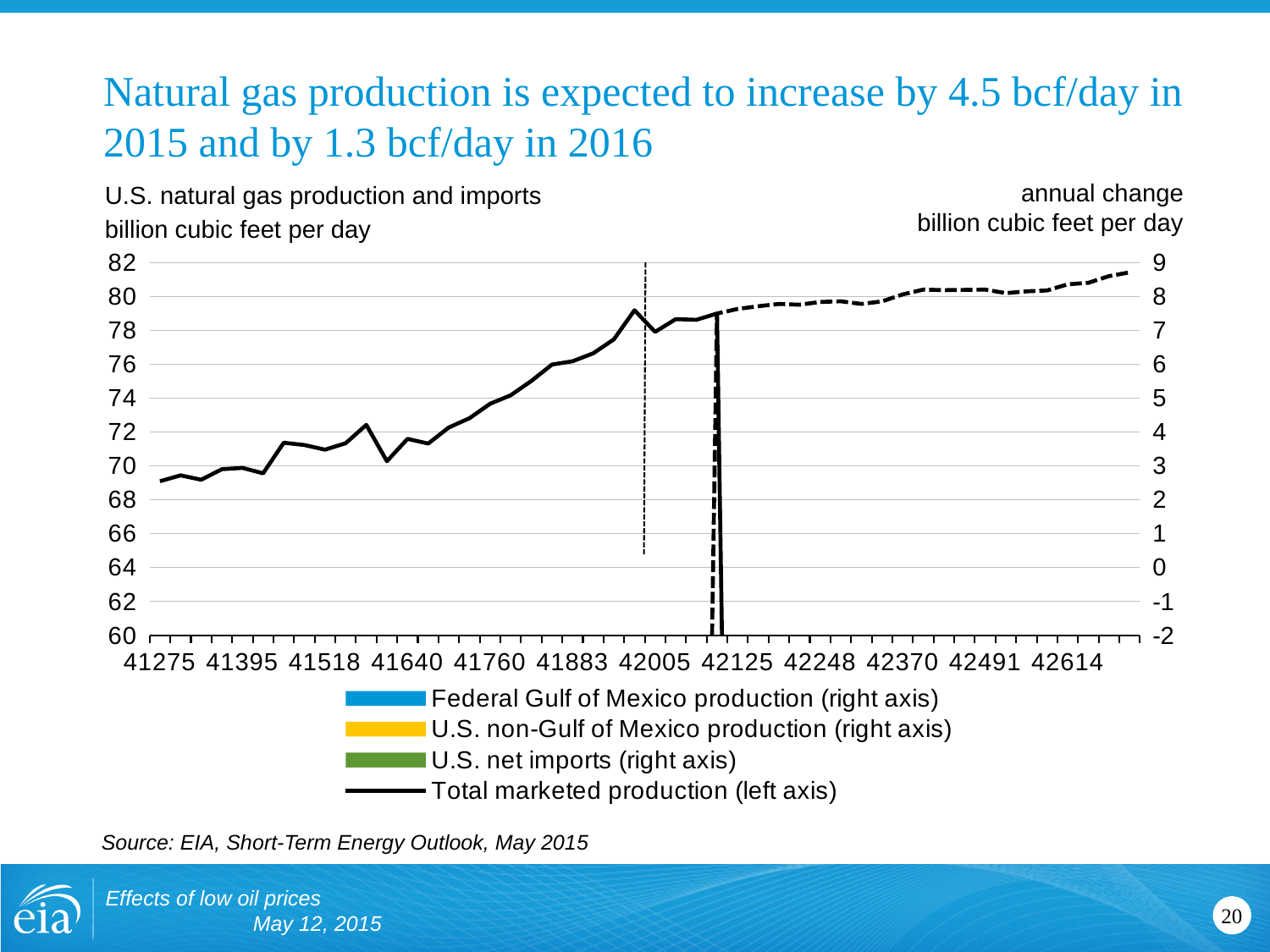
How many series does the legend list? 4 What is the lowest value shown on the right axis? -2 What is the title of the chart? U.S. natural gas production and imports What is the highest value shown on the left axis? 82 Is the value of Total marketed production at 41640 greater or less than 74? less Is the value of Total marketed production at 41275 greater or less than 72? less Is the value of Total marketed production higher at 42614 or at 41275? 42614 Is the value of Total marketed production at 42005 greater or less than 76? greater Does the Total marketed production line generally rise or fall from left to right along the x axis? rise What kind of chart is shown on the slide? line chart